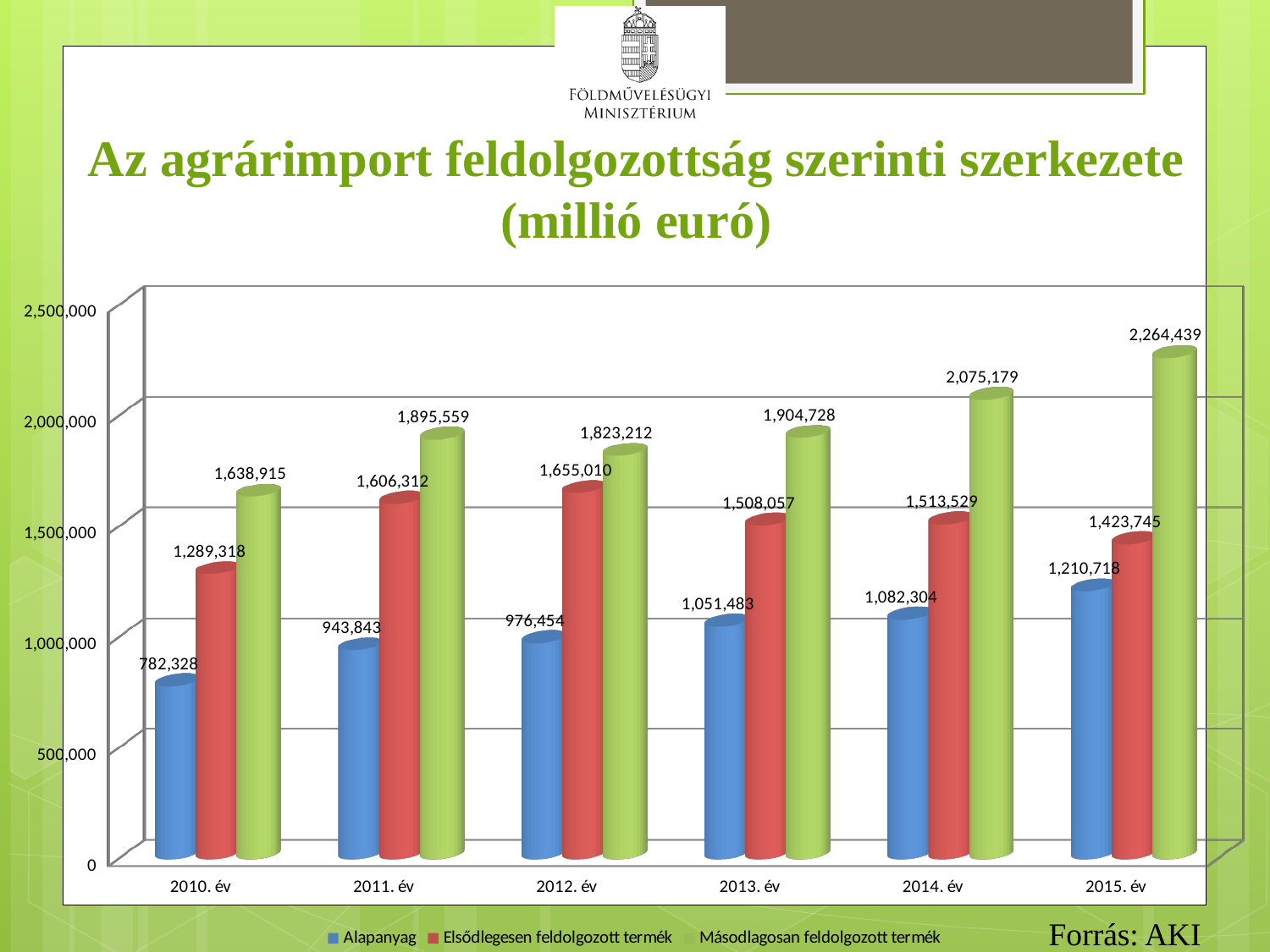
What is the value for Másodlagosan feldolgozott termék in 2015. év? 2,264,439 How many years are shown on the x axis? 6 In which year is the Alapanyag value lowest? 2010. év What is the difference between the Alapanyag values for 2015. év and 2010. év? 428,390 What is the value for Elsődlegesen feldolgozott termék in 2012. év? 1,655,010 What kind of chart is shown on the slide? Bar chart Is the value for Alapanyag in 2014. év greater or less than 1,000,000? greater How many series does the legend list? 3 In which year is the Másodlagosan feldolgozott termék value highest? 2015. év Does the Alapanyag value rise or fall from 2010. év to 2015. év? Rise What is the value for Alapanyag in 2010. év? 782,328 Which is larger in 2013. év: Elsődlegesen feldolgozott termék or Másodlagosan feldolgozott termék? Másodlagosan feldolgozott termék